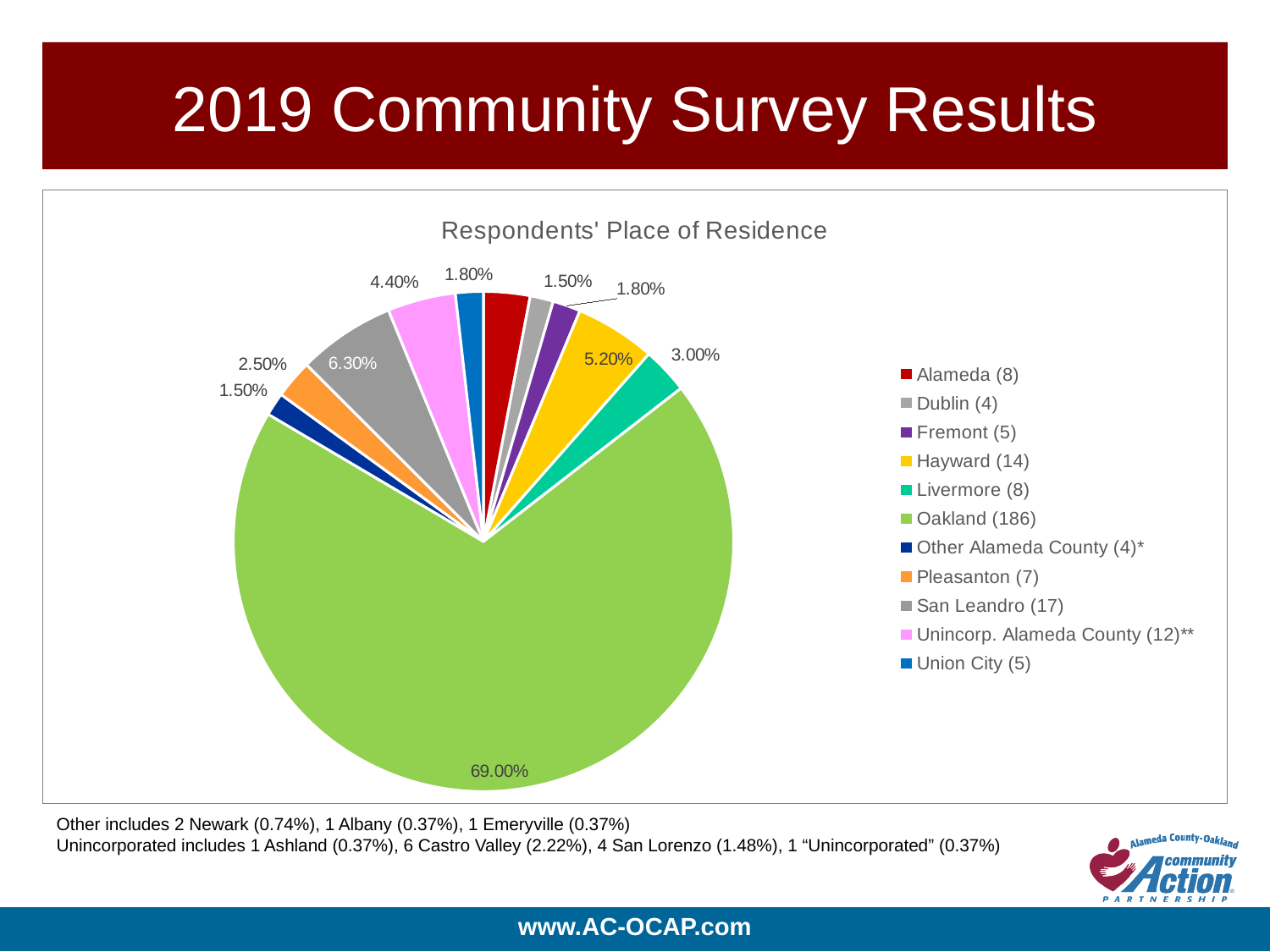
What percentage of respondents live in Hayward? 5.20% What percentage of respondents live in Oakland? 69.00% What is the title of the chart? Respondents' Place of Residence How many respondents are from Oakland according to the legend? 186 What colour is the Oakland slice of the pie chart? green What type of chart is shown on the slide? pie chart Which has more respondents, Hayward or Pleasanton? Hayward What is the difference in respondent counts between San Leandro (17) and Hayward (14)? 3 How many categories does the legend of the pie chart list? 11 What percentage of respondents live in San Leandro? 6.30% Which place of residence has the largest share of respondents? Oakland How many respondents are from San Leandro according to the legend? 17